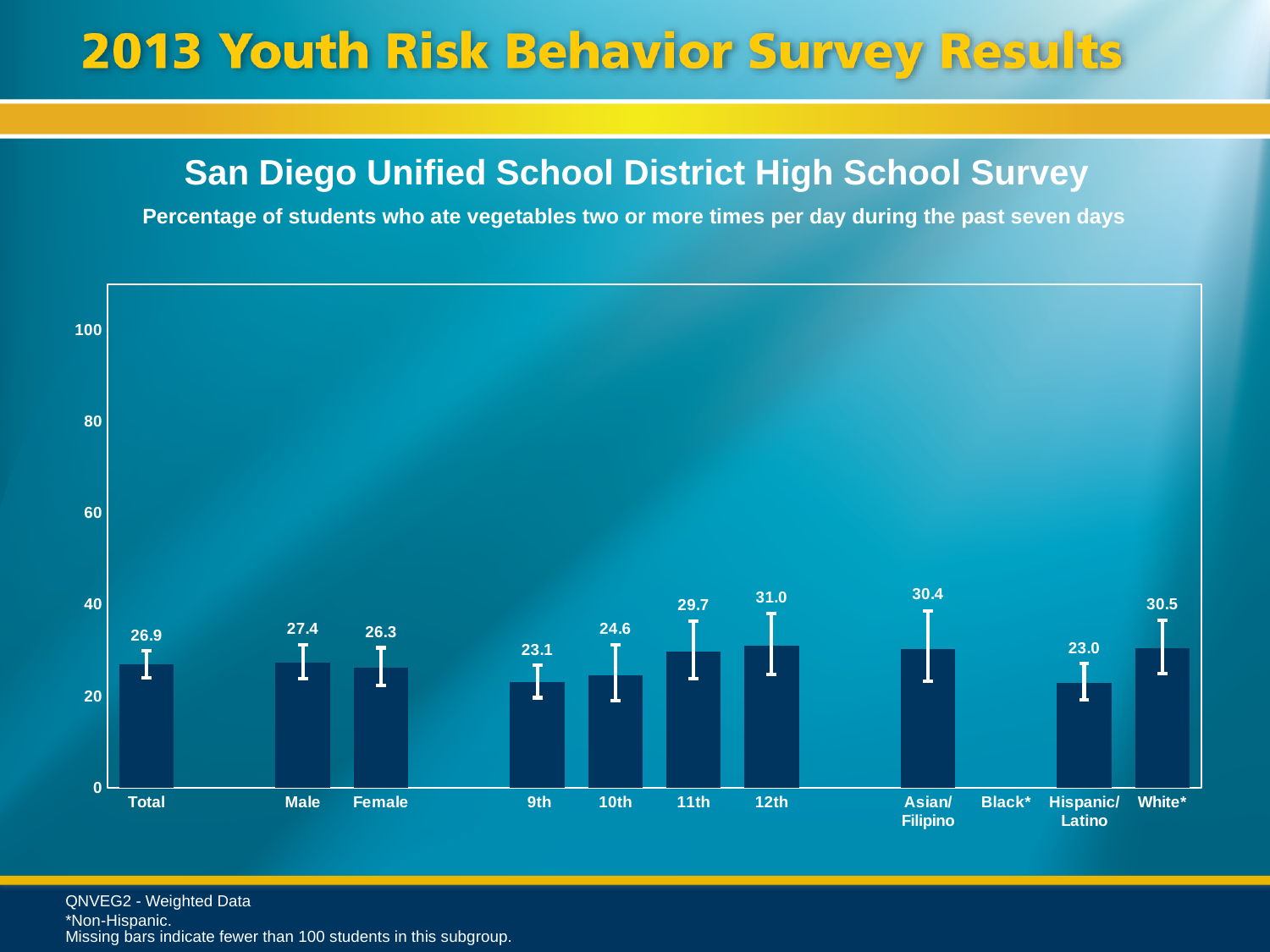
What kind of chart is shown? bar chart Is the value for White* greater or less than 40? less Which category label has no bar plotted? Black* What is the value for Hispanic/Latino? 23.0 Do the values rise or fall from 9th grade to 12th grade? rise How many bars are plotted on the chart? 10 Which grade level has the highest value? 12th What is the value for Total? 26.9 What is the difference between the Male and Female values? 1.1 Which category has the lowest value? Hispanic/Latino Which is larger, the value for Asian/Filipino or the value for Hispanic/Latino? Asian/Filipino What is the value for 12th grade? 31.0